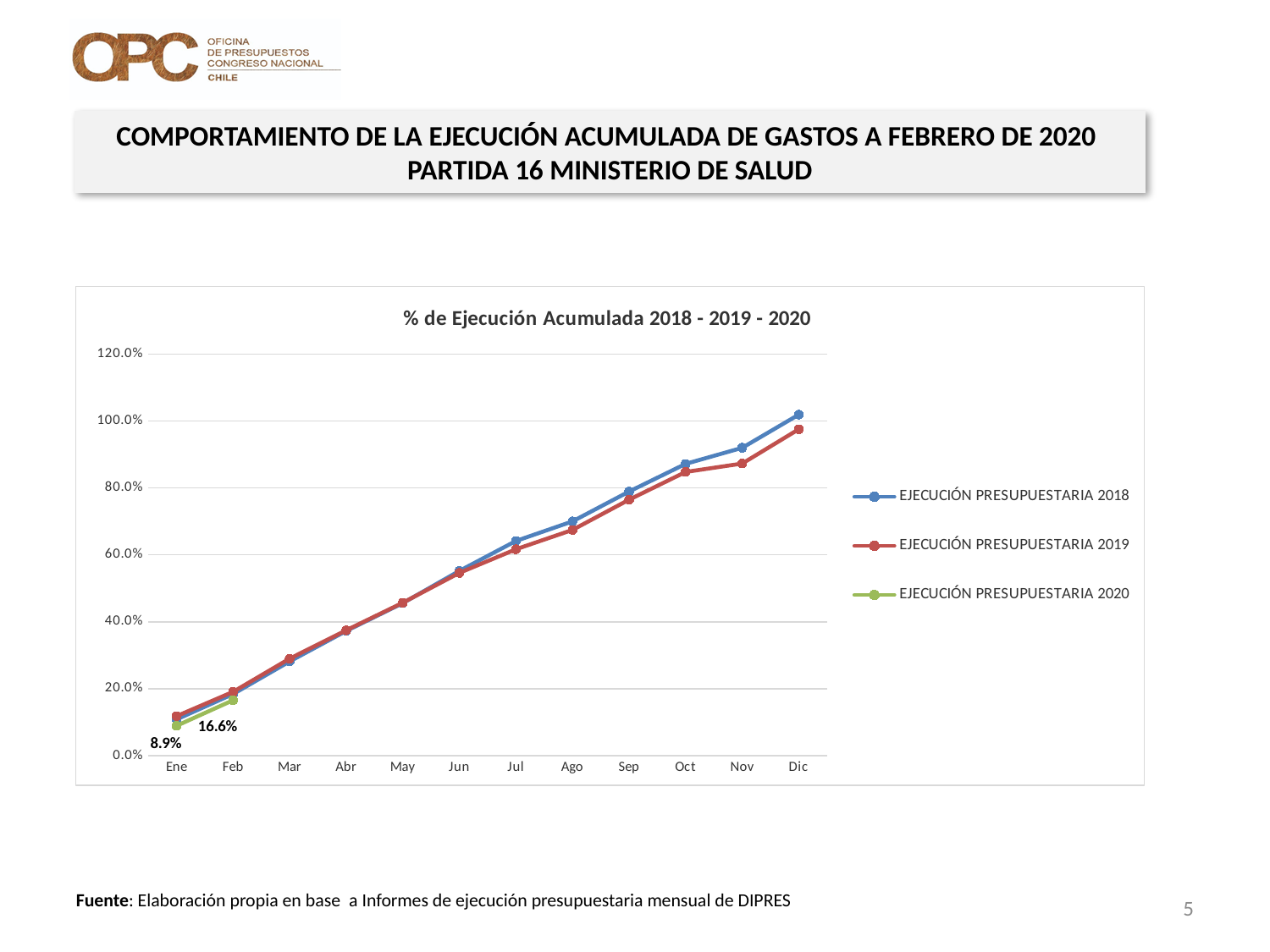
Do the values for EJECUCIÓN PRESUPUESTARIA 2018 rise or fall from Ene to Dic? rise What is the title of the chart? % de Ejecución Acumulada 2018 - 2019 - 2020 How many series does the legend list? 3 What is the value for EJECUCIÓN PRESUPUESTARIA 2020 in Ene? 8.9% By how much did EJECUCIÓN PRESUPUESTARIA 2020 increase from Ene to Feb? 7.7% In Dic, which series has the higher value: EJECUCIÓN PRESUPUESTARIA 2018 or EJECUCIÓN PRESUPUESTARIA 2019? EJECUCIÓN PRESUPUESTARIA 2018 Is the value for EJECUCIÓN PRESUPUESTARIA 2019 in Jun greater or less than 60.0%? less Is the value for EJECUCIÓN PRESUPUESTARIA 2019 in Dic greater or less than 100.0%? less What kind of chart is shown on the slide? line chart How many months are shown on the x axis? 12 What is the value for EJECUCIÓN PRESUPUESTARIA 2020 in Feb? 16.6% Is the value for EJECUCIÓN PRESUPUESTARIA 2018 in Nov greater or less than 80.0%? greater